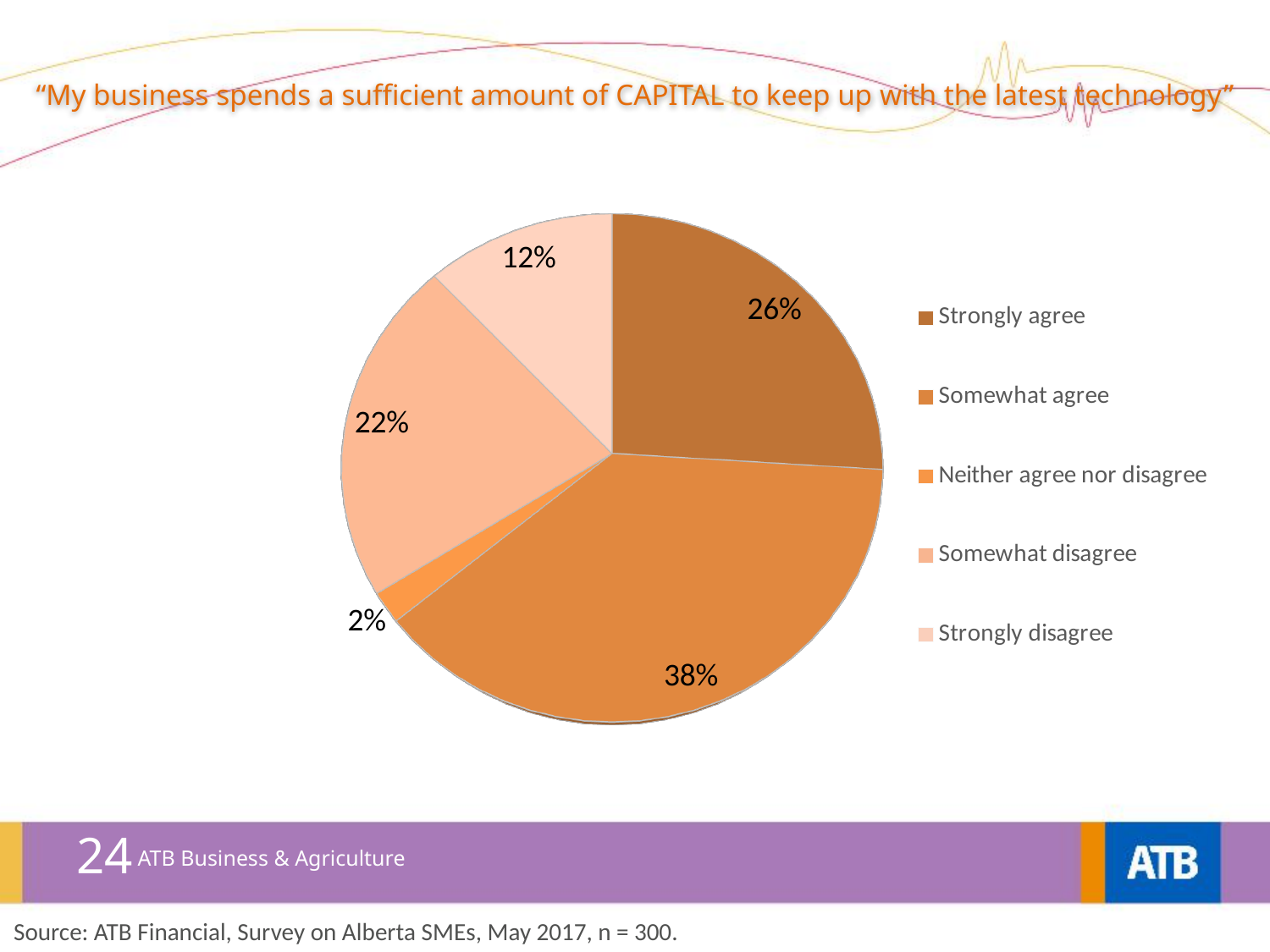
What percentage of respondents somewhat disagree? 22% What share of the pie is labelled Somewhat agree? 38% What type of chart is shown on the slide? Pie chart What is the difference in percentage points between Somewhat agree and Strongly agree? 12 Which response category has the largest slice of the pie? Somewhat agree What percentage of respondents strongly disagree? 12% How many response categories does the pie chart show? 5 What statement were respondents asked to rate, according to the slide title? "My business spends a sufficient amount of CAPITAL to keep up with the latest technology" What percentage of respondents strongly agree that their business spends a sufficient amount of capital to keep up with the latest technology? 26% What percentage of respondents neither agree nor disagree? 2% Which is larger, the Somewhat disagree slice or the Strongly disagree slice? Somewhat disagree Which response category has the smallest slice of the pie? Neither agree nor disagree